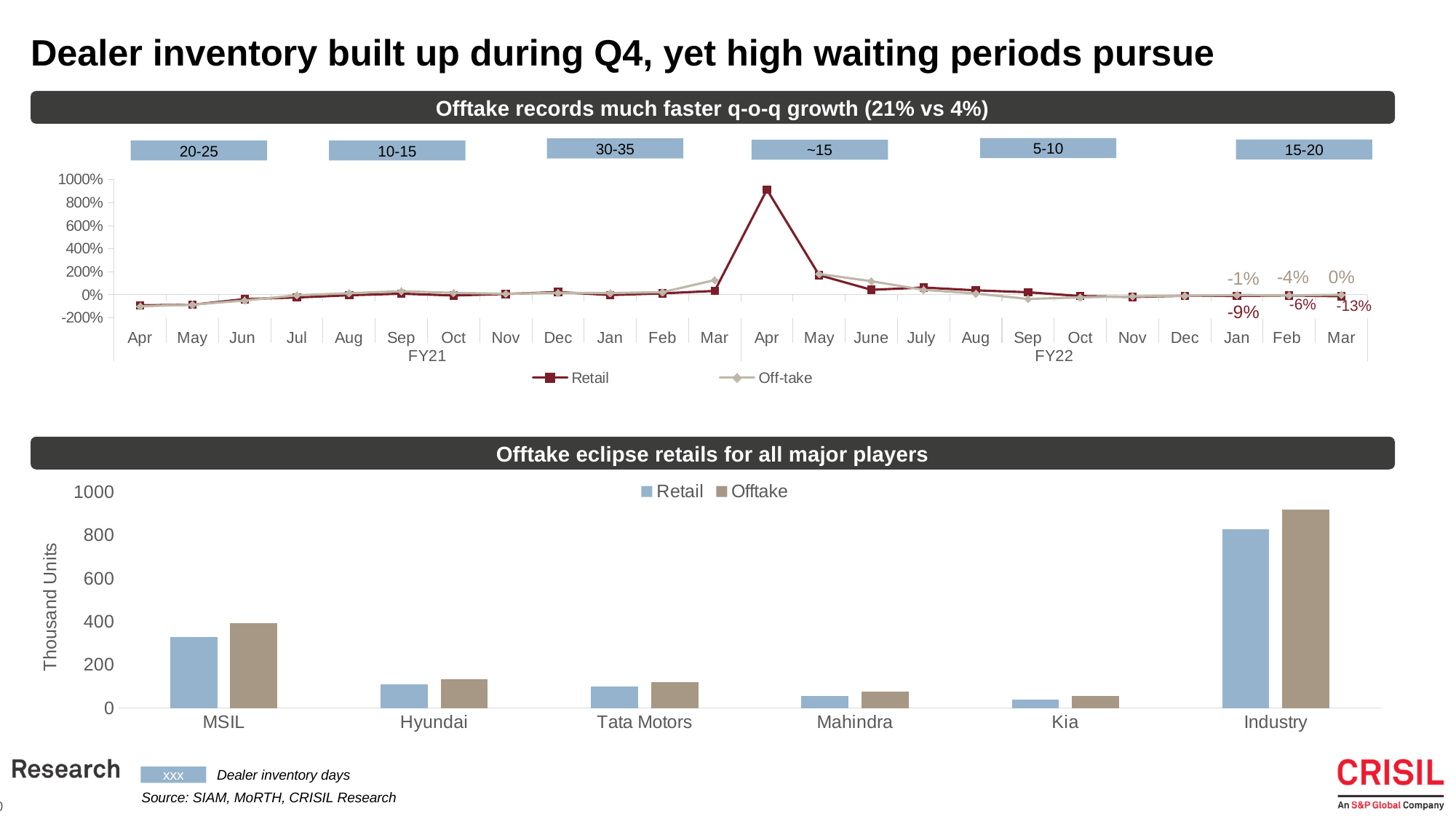
What kind of chart is the top chart titled 'Offtake records much faster q-o-q growth (21% vs 4%)'? Line chart What kind of chart is the bottom chart titled 'Offtake eclipse retails for all major players'? Bar chart In the top chart, how many series does the legend list? 2 In the top chart, in which month does the Retail series reach its highest value? Apr FY22 In the top chart, what is the Off-take value for Feb FY22? -4% In the top chart, what is the difference between the Off-take value and the Retail value in Mar FY22? 13% In the top chart, what is the Retail value for Mar FY22? -13% In the bottom chart, is the Offtake value for Industry greater or less than 800? greater In the top chart, what is the Retail value for Jan FY22? -9% In the bottom chart, how many categories are shown on the x axis? 6 In the bottom chart, what is the label of the vertical axis? Thousand Units In the bottom chart, is the Retail value for MSIL greater or less than 400? less